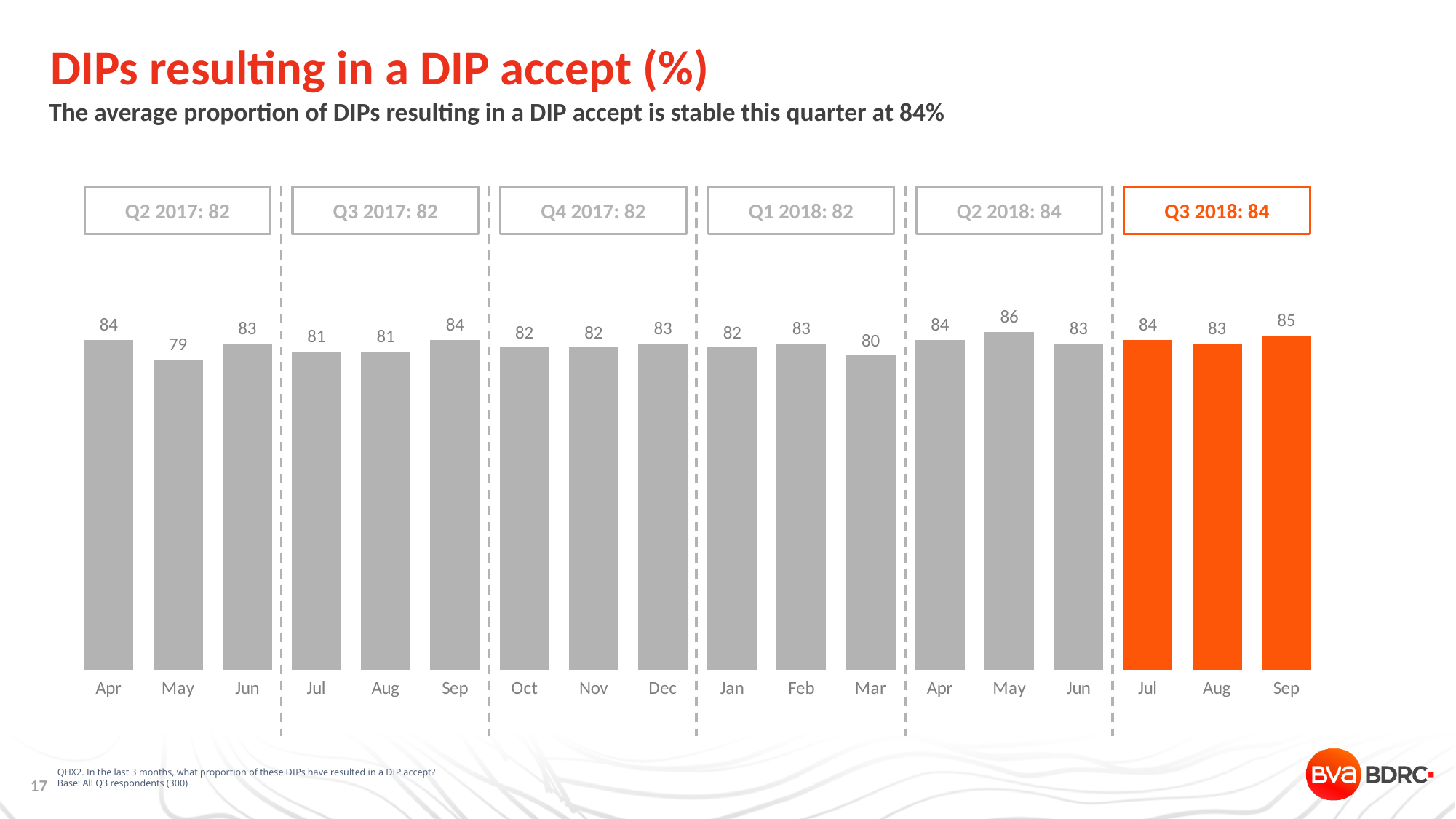
Which quarter's bars are highlighted in orange? Q3 2018 What is the value for Mar in Q1 2018? 80 Which month has the highest value on the chart? May (Q2 2018) What is the difference between the highest value (May 2018) and the lowest value (May 2017)? 7 What type of chart is shown on the slide? Bar chart What is the difference between the values for Sep 2018 and Jul 2018? 1 Which month has the lowest value on the chart? May (Q2 2017) What is the value for May in Q2 2018? 86 How many monthly bars are plotted on the chart? 18 What is the value for Sep in Q3 2018? 85 Which is larger, the value for Jan 2018 or the value for Feb 2018? Feb 2018 What is the quarterly average shown in the box for Q3 2018? 84